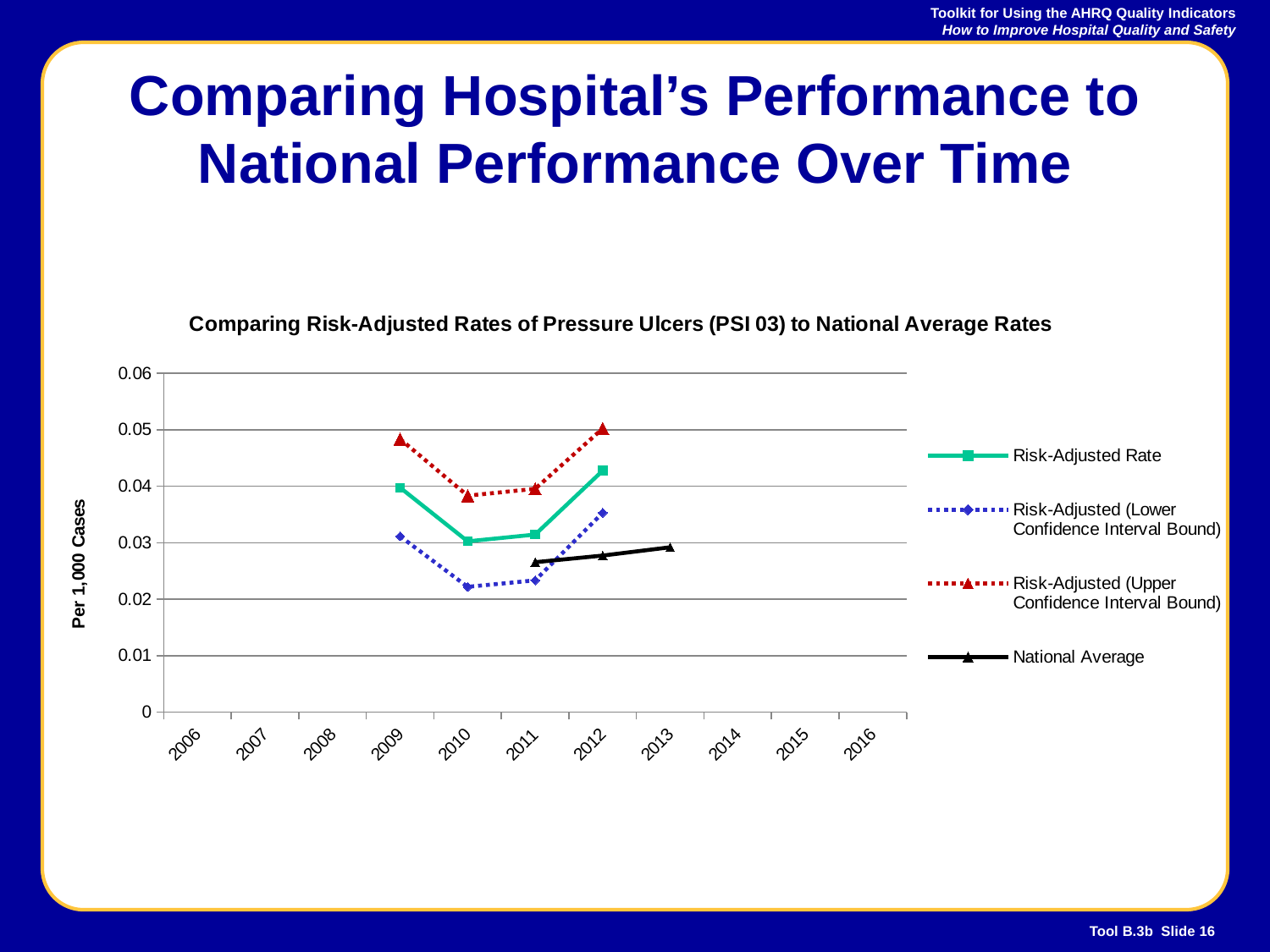
How many data points are plotted for the National Average series? 3 How many years are labelled on the x axis? 11 Is the Risk-Adjusted (Lower Confidence Interval Bound) value for 2010 greater or less than 0.03? less Is the Risk-Adjusted Rate value for 2012 greater or less than 0.04? greater Does the National Average rise or fall from 2011 to 2013? Rise How many series does the legend list? 4 In which year is the Risk-Adjusted Rate highest? 2012 In 2012, which is larger: the Risk-Adjusted Rate or the National Average? Risk-Adjusted Rate What kind of chart is shown on the slide? Line chart Is the Risk-Adjusted (Upper Confidence Interval Bound) value for 2009 greater or less than 0.04? greater How many data points are plotted for the Risk-Adjusted Rate series? 4 What is the label on the y axis? Per 1,000 Cases